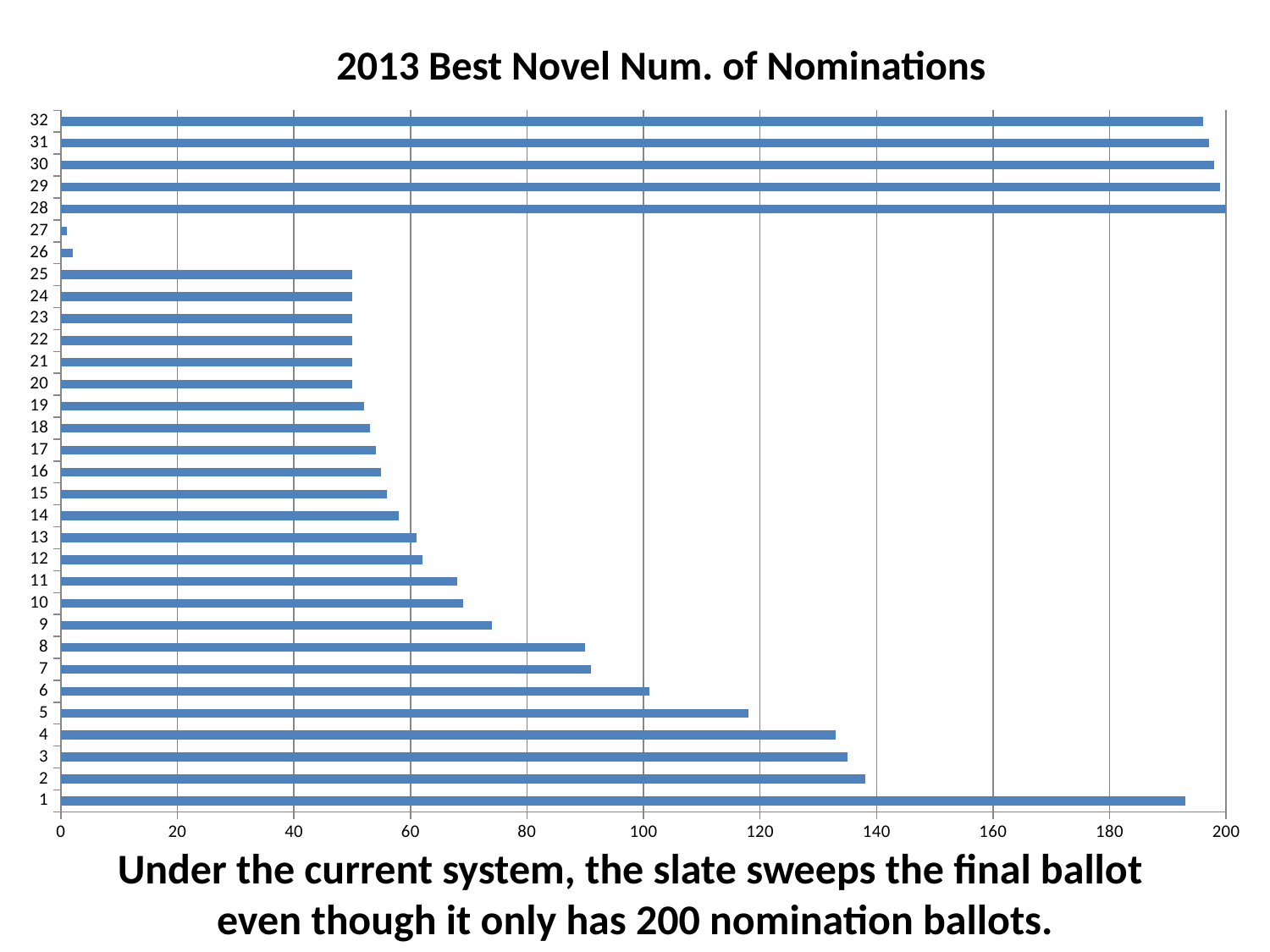
Which has the larger value, category 5 or category 6? category 5 Which has the larger value, category 26 or category 25? category 25 What is the title of the chart? 2013 Best Novel Num. of Nominations What kind of chart is shown on the slide? bar chart Is the value for category 1 greater or less than 180? greater What is the value for category 28? 200 How many categories (bars) are plotted in the chart? 32 Is the value for category 27 greater or less than 20? less Is the value for category 4 greater or less than 120? greater Which has the larger value, category 1 or category 2? category 1